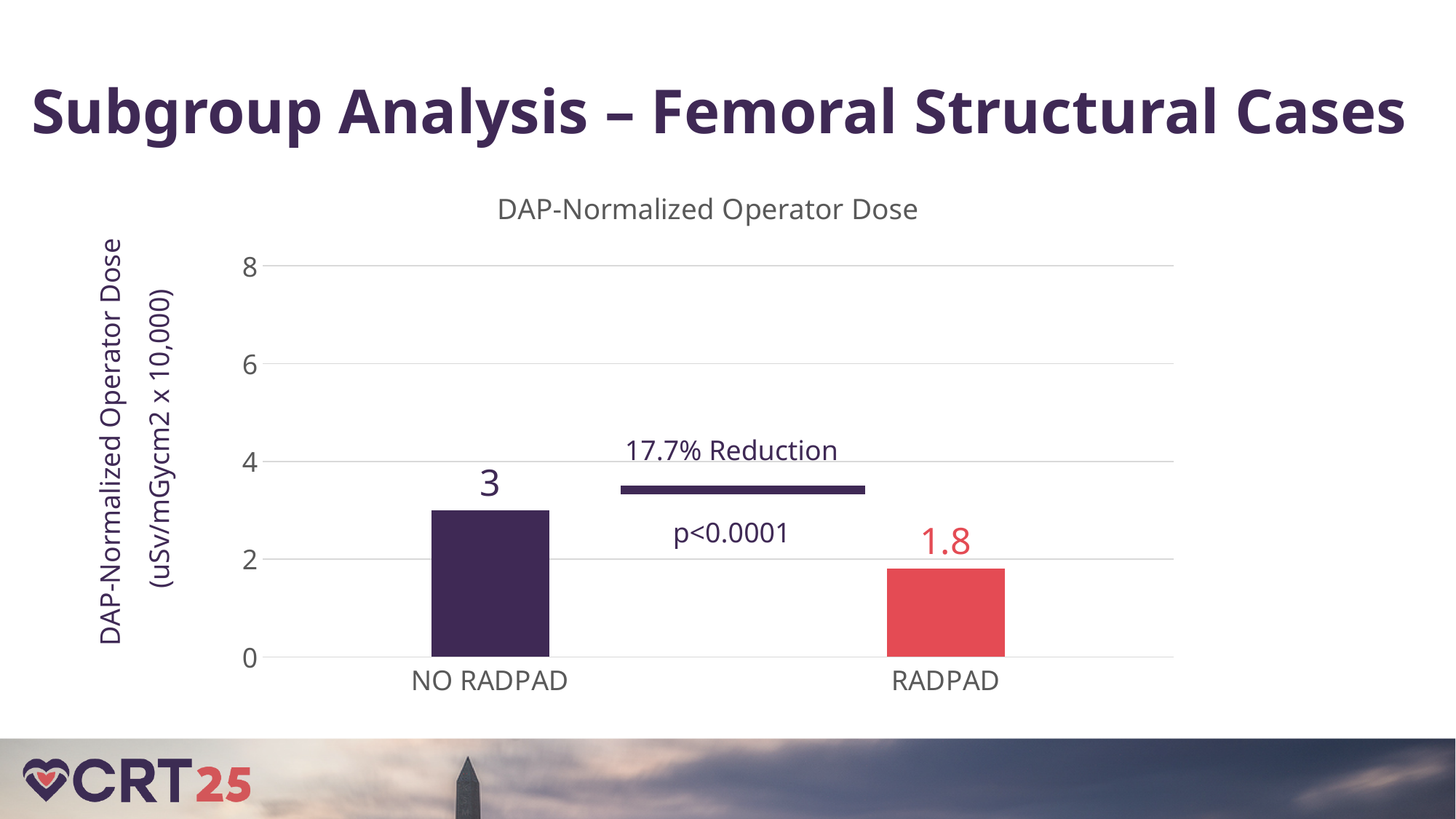
Which category has the higher DAP-normalized operator dose? NO RADPAD What is the DAP-normalized operator dose for RADPAD? 1.8 What is the difference between the NO RADPAD and RADPAD values? 1.2 Is the value for RADPAD greater or less than 2? less Is the value for NO RADPAD greater or less than 4? less How many categories are shown on the x axis? 2 What is the DAP-normalized operator dose for NO RADPAD? 3 What is the title of the chart? DAP-Normalized Operator Dose What percentage reduction is annotated on the chart? 17.7% Reduction What kind of chart is shown on the slide? bar chart Is the value for NO RADPAD larger or smaller than the value for RADPAD? larger Which category has the lower DAP-normalized operator dose? RADPAD